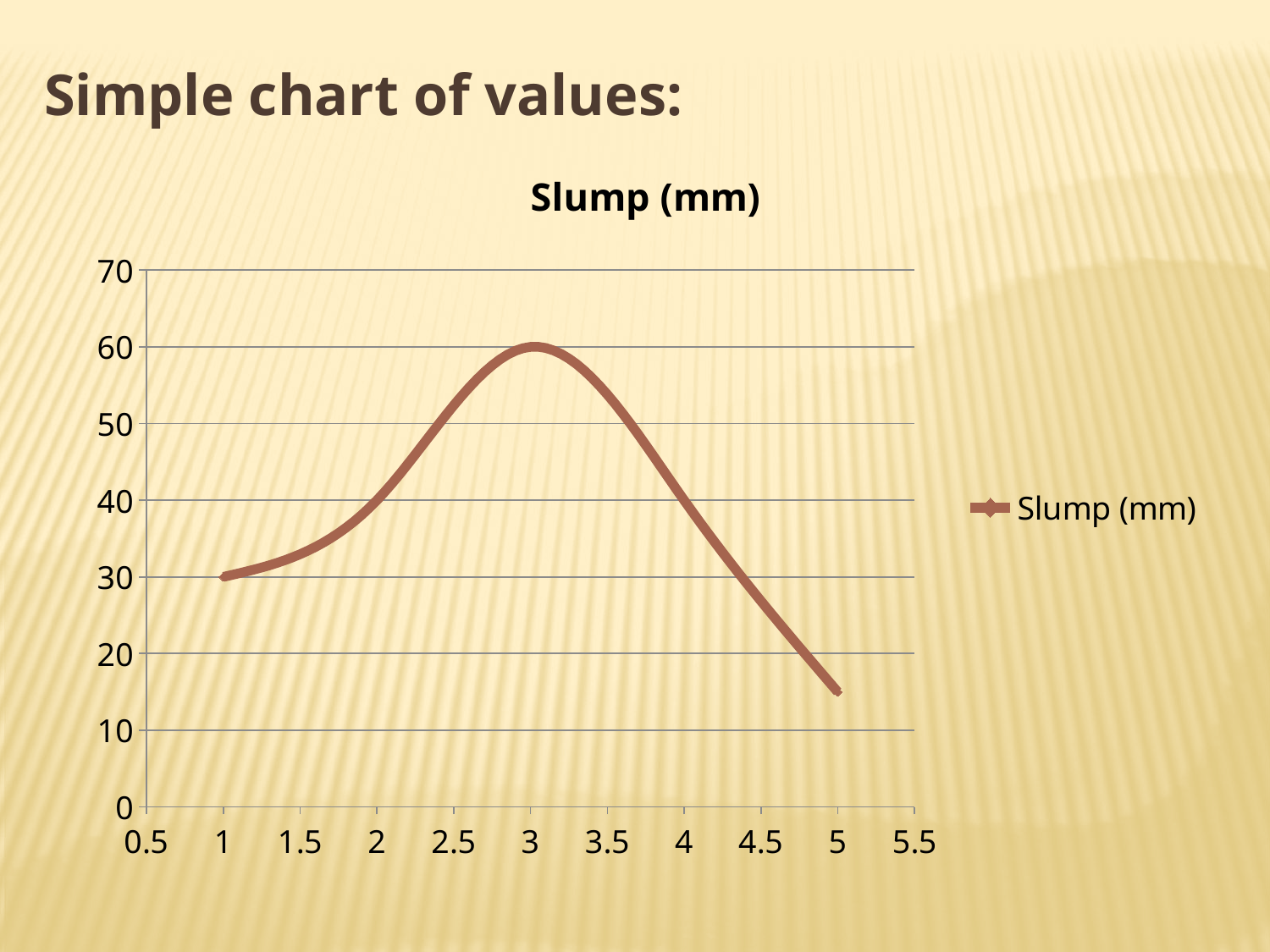
What kind of chart is shown on the slide? line chart At which x value does the Slump (mm) line reach its lowest point? 5 Is the Slump (mm) value at x = 2 greater or less than 30? greater What is the Slump (mm) value at x = 3? 60 What is the Slump (mm) value at x = 1? 30 Is the Slump (mm) value at x = 4 greater or less than 50? less Is the Slump (mm) value at x = 5 greater or less than 20? less How does the Slump (mm) value change as x increases from 1 to 5? rises to a peak at 3, then falls What is the title of the chart? Slump (mm) Which is larger, the Slump (mm) value at x = 1 or at x = 5? x = 1 At which x value does the Slump (mm) line reach its highest point? 3 How many series does the legend list? 1